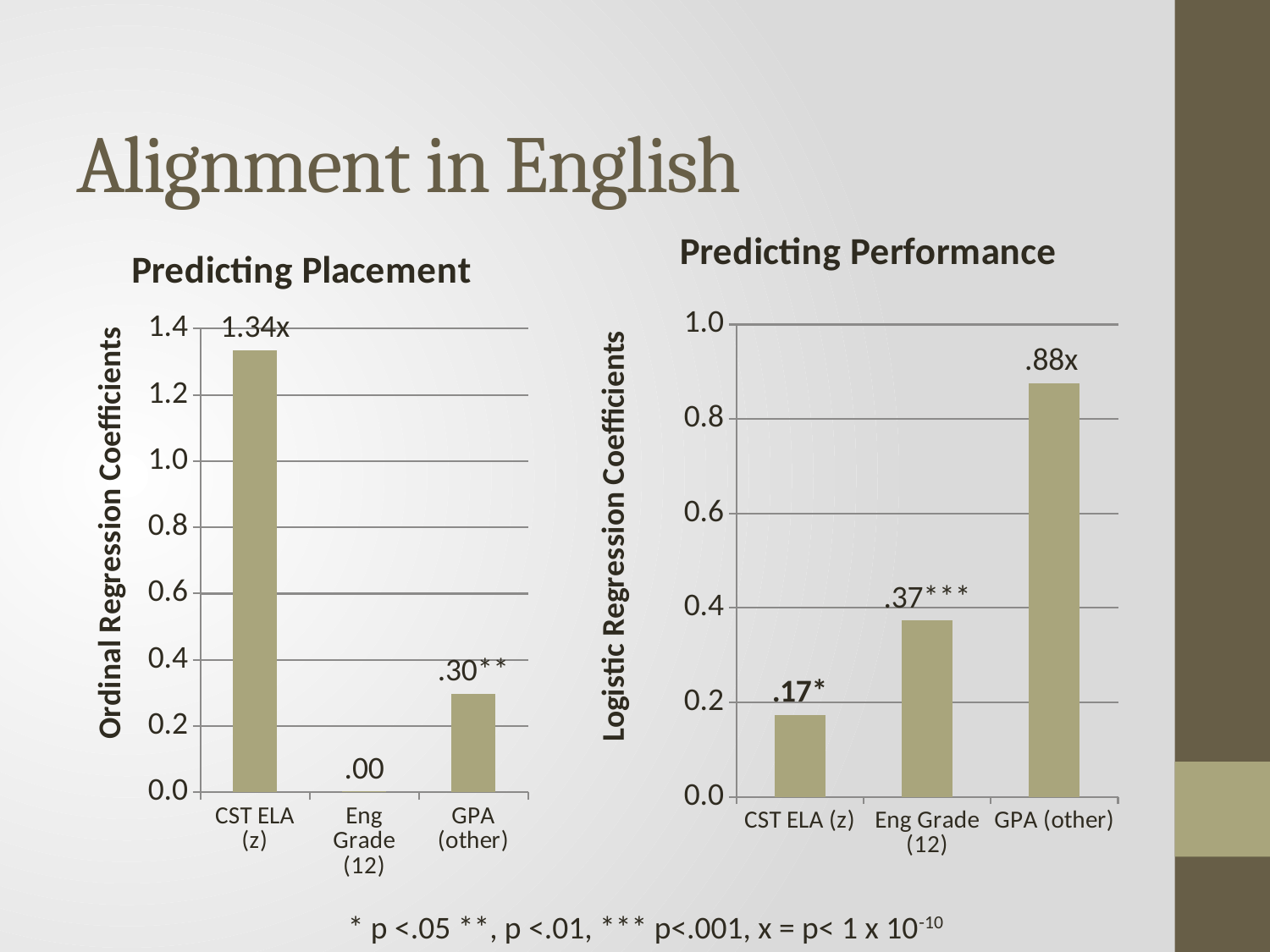
In the Predicting Performance chart, what is the value shown for GPA (other)? .88x How many categories are shown on the x axis of the Predicting Placement chart? 3 What kind of chart is the Predicting Performance chart? bar chart In the Predicting Placement chart, what is the value shown for GPA (other)? .30** In the Predicting Placement chart, what is the value shown for Eng Grade (12)? .00 In the Predicting Performance chart, is the value for CST ELA (z) larger or smaller than the value for Eng Grade (12)? smaller In the Predicting Placement chart, what is the value shown for CST ELA (z)? 1.34x In the Predicting Performance chart, which category has the lowest value? CST ELA (z) In the Predicting Placement chart, which category has the lowest value? Eng Grade (12) What is the y-axis label of the Predicting Performance chart? Logistic Regression Coefficients In the Predicting Performance chart, which category has the highest value? GPA (other) In the Predicting Performance chart, what is the value shown for Eng Grade (12)? .37***